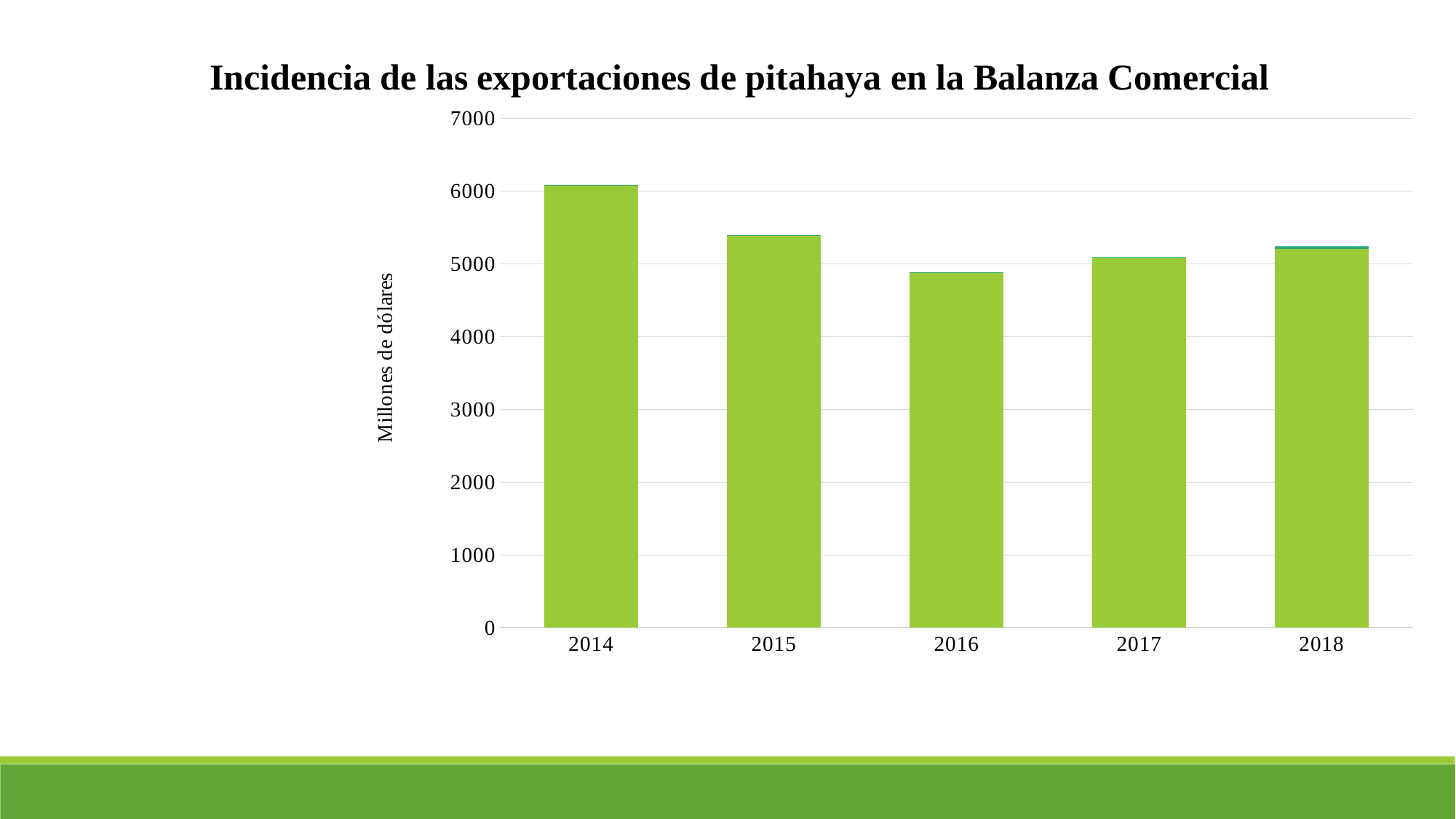
Which year has the lowest bar in the chart? 2016 What kind of chart is shown on the slide? bar chart What is the title of the chart? Incidencia de las exportaciones de pitahaya en la Balanza Comercial Is the value for 2016 greater or less than 5000? less Which year has the larger value, 2014 or 2018? 2014 Is the value for 2015 greater or less than 5000? greater Do the values rise or fall from 2014 to 2016? fall Is the value for 2014 greater or less than 6000? greater How many years are shown on the x axis of the chart? 5 Which year has the larger value, 2015 or 2017? 2015 Which year has the highest bar in the chart? 2014 What is the label on the y axis of the chart? Millones de dólares